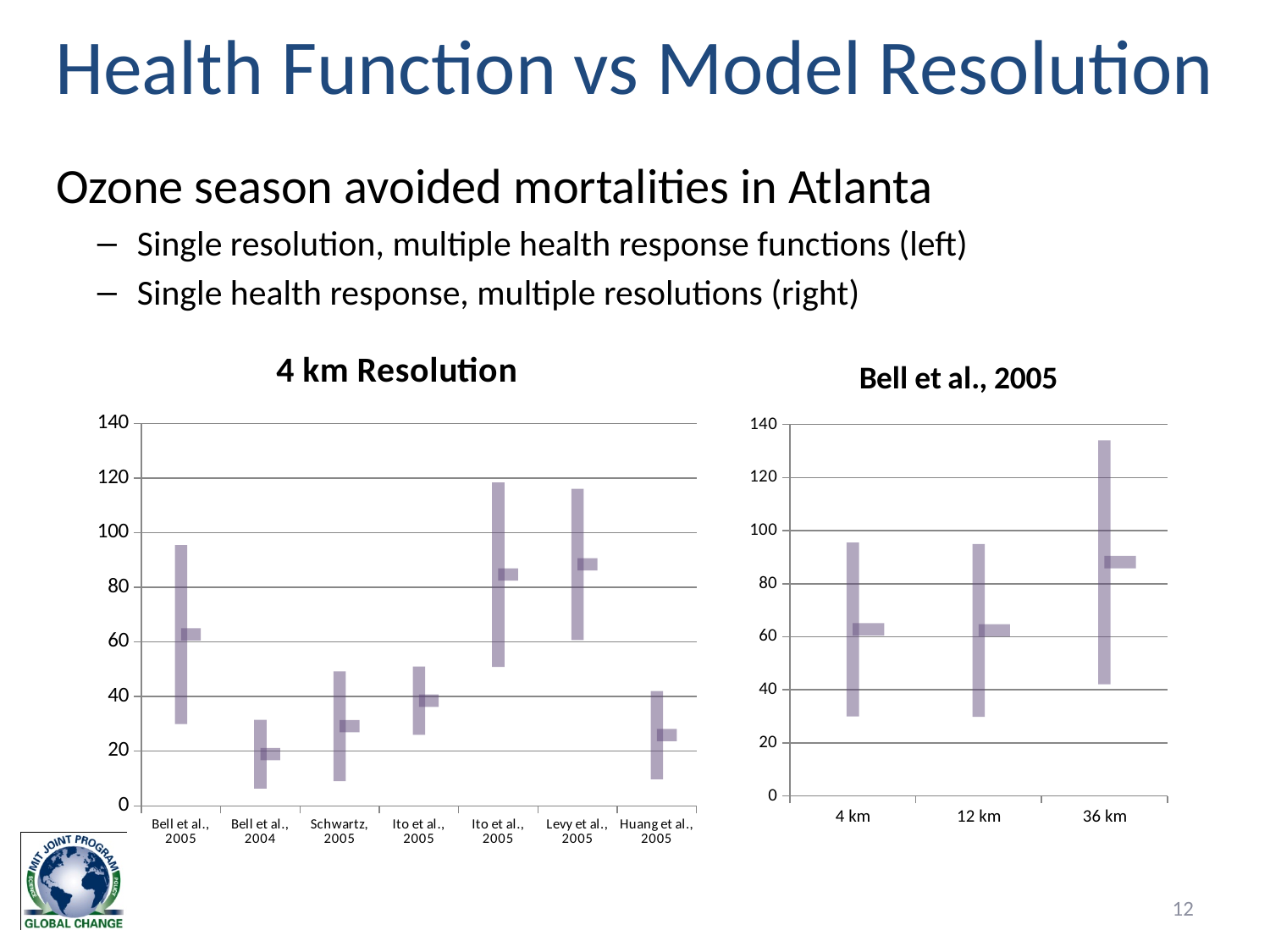
In the 4 km Resolution chart, is the central value for Bell et al., 2004 greater or less than 40? less In the Bell et al., 2005 chart, is the central value for 4 km greater or less than 80? less What is the title of the chart on the right side of the slide? Bell et al., 2005 In the 4 km Resolution chart, which has the larger central value, Bell et al., 2005 or Bell et al., 2004? Bell et al., 2005 In the 4 km Resolution chart, how many categories are shown on the x axis? 7 In the 4 km Resolution chart, is the central value for Bell et al., 2005 greater or less than 40? greater In the Bell et al., 2005 chart, how many resolutions are shown on the x axis? 3 In the Bell et al., 2005 chart, which resolution has the highest central value? 36 km In the 4 km Resolution chart, which study has the lowest central value? Bell et al., 2004